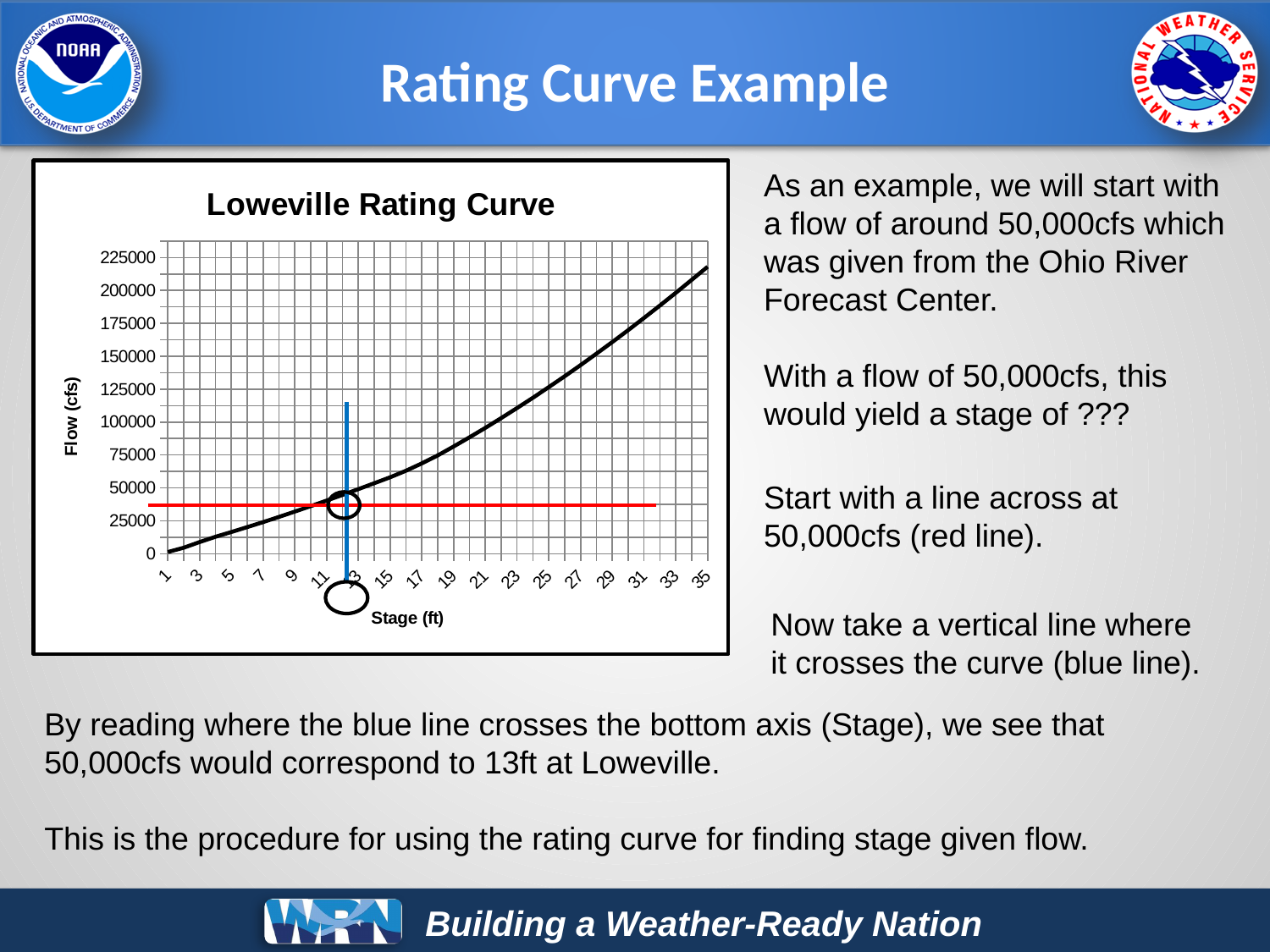
Is the flow at a stage of 25 ft greater or less than 100000 cfs on the Loweville Rating Curve? greater According to the slide, what flow value does the red horizontal line on the Loweville Rating Curve represent? 50,000cfs Does the flow rise or fall as stage increases along the x-axis of the Loweville Rating Curve? rise What kind of chart is the Loweville Rating Curve? line chart What is the label of the y-axis on the Loweville Rating Curve chart? Flow (cfs) What is the title of the chart on the slide? Loweville Rating Curve Is the flow at a stage of 29 ft greater or less than 150000 cfs on the Loweville Rating Curve? greater What is the highest value shown on the y-axis of the Loweville Rating Curve chart? 225000 According to the slide, at what stage does the blue vertical line cross the bottom axis of the Loweville Rating Curve? 13ft Is the flow at a stage of 35 ft greater or less than 200000 cfs on the Loweville Rating Curve? greater